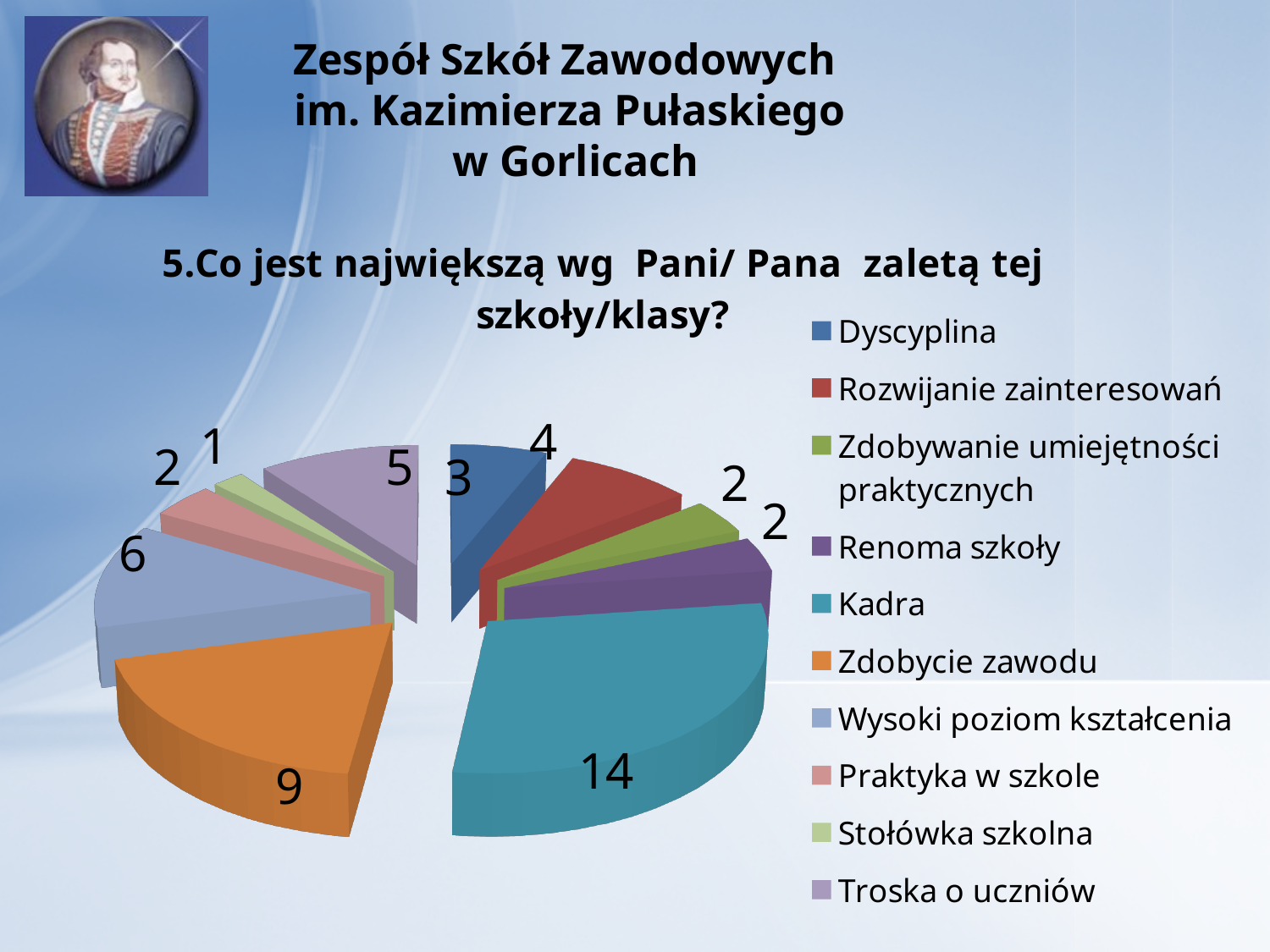
What is the value for Zdobycie zawodu? 9 Which is larger, the value for Rozwijanie zainteresowań or the value for Troska o uczniów? Troska o uczniów What is the value for Dyscyplina? 3 What is the value for Kadra? 14 How many categories does the legend list? 10 What is the total of all the values in the pie chart? 48 Which category has the largest slice? Kadra What is the value for Wysoki poziom kształcenia? 6 What is the value for Troska o uczniów? 5 What type of chart is shown on the slide? pie chart What is the difference between the values for Kadra and Zdobycie zawodu? 5 Which category has the smallest slice? Stołówka szkolna